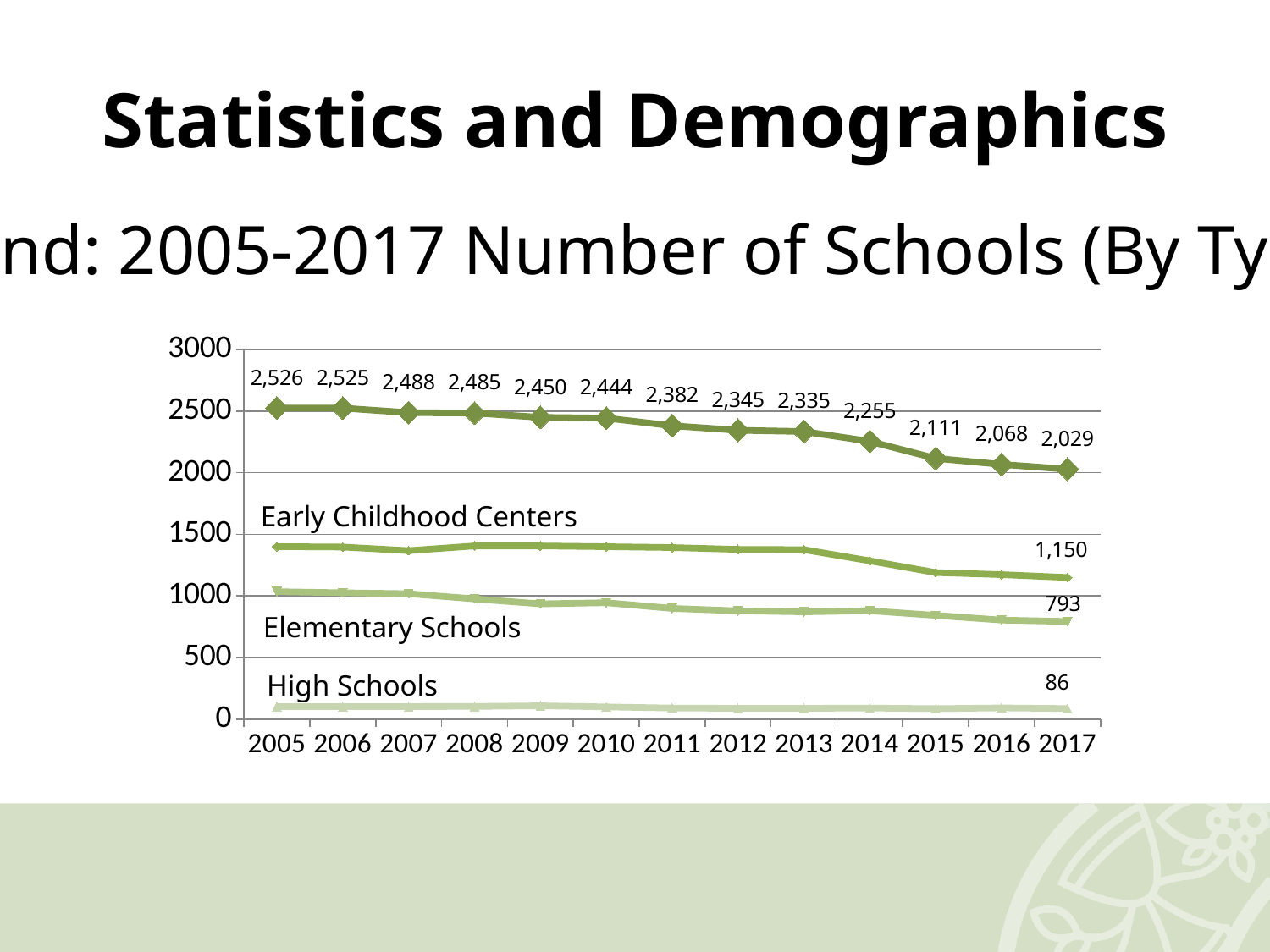
What is the value for Elementary Schools in 2017? 793 What is the value of the topmost line in 2017? 2,029 Is the value for Early Childhood Centers in 2005 greater or less than 1500? less By how much did the topmost line decrease from 2005 to 2017? 497 What is the value for Early Childhood Centers in 2017? 1,150 What kind of chart is shown on the slide? line chart What is the value for High Schools in 2017? 86 How many years are shown on the x axis? 13 In which year does the topmost line reach its highest value? 2005 Does the topmost line rise or fall from 2005 to 2017? fall What is the difference between the topmost line's values in 2014 and 2015? 144 What is the value of the topmost line in 2005? 2,526